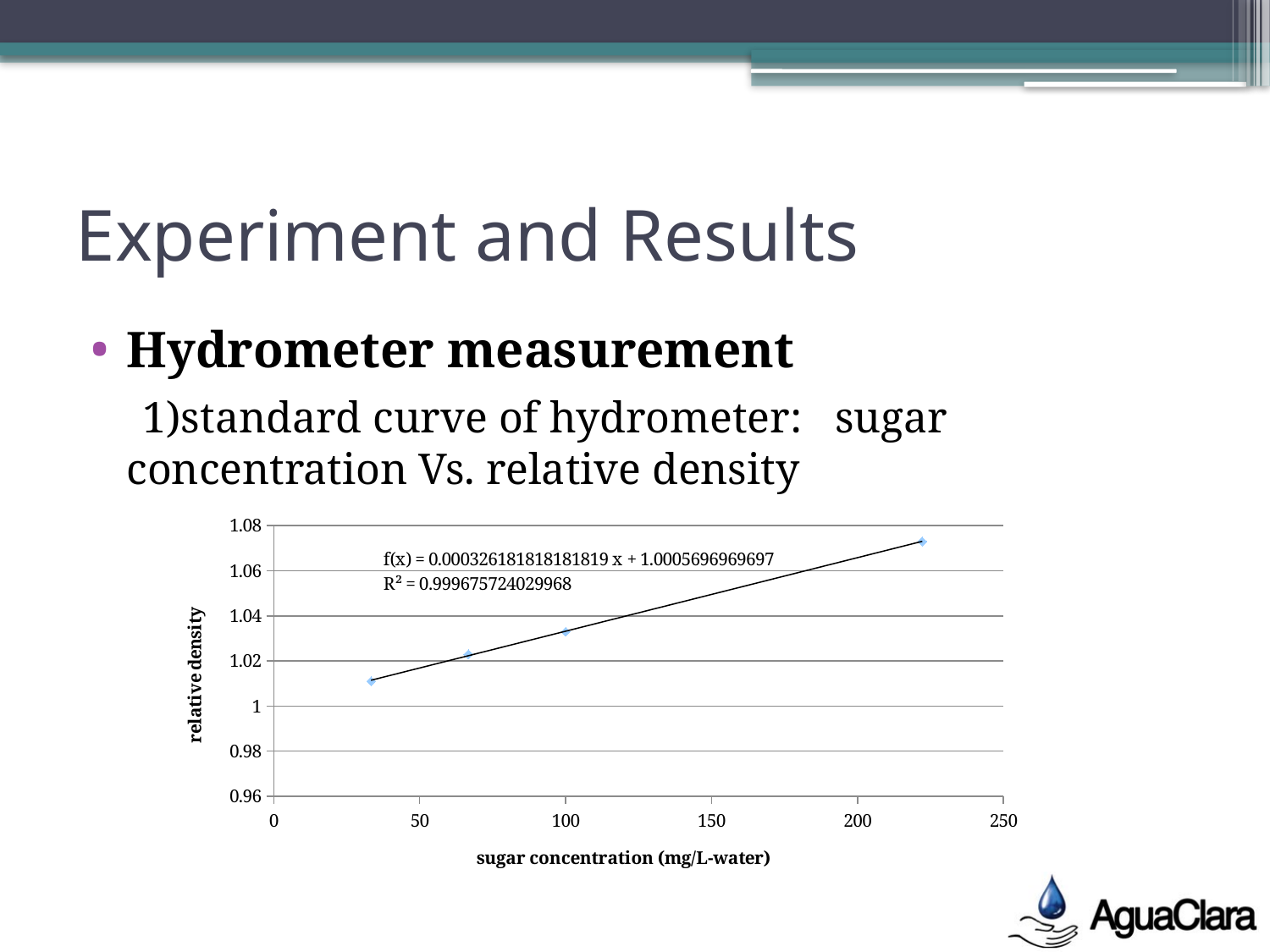
Is the relative density of the data point near 100 mg/L-water greater or less than 1.02? greater Is the sugar concentration of the rightmost data point greater or less than 200 mg/L-water? greater What is the trendline equation printed on the chart? f(x) = 0.000326181818181819 x + 1.0005696969697 Does relative density rise or fall as sugar concentration increases along the x axis? rise How many data points are plotted on the chart? 4 Is the sugar concentration of the leftmost data point greater or less than 50 mg/L-water? less What kind of chart is shown on the slide? scatter chart What R² value is printed on the chart? 0.999675724029968 What is the title of the x axis of the chart? sugar concentration (mg/L-water)